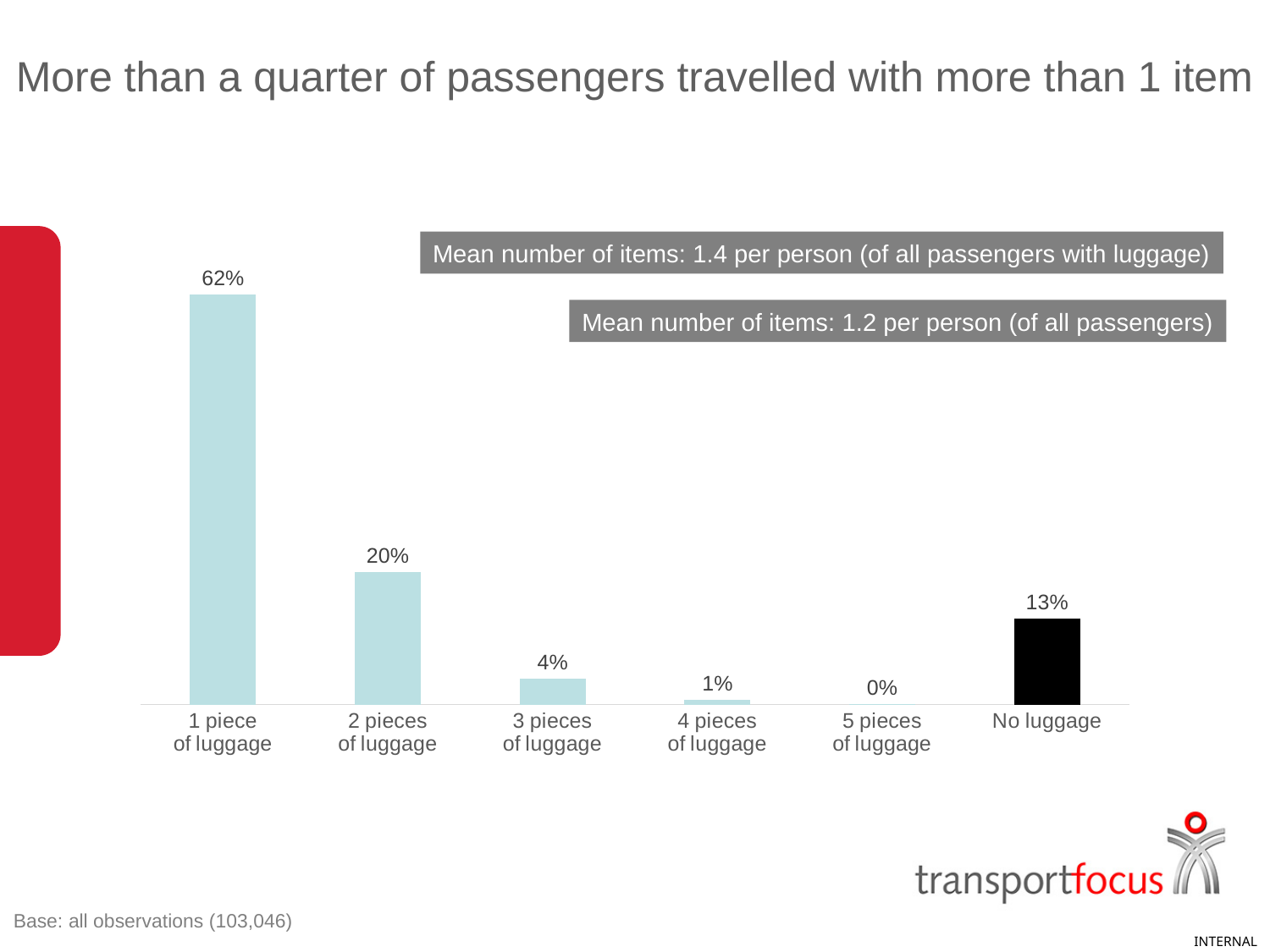
How many categories are shown on the x axis? 6 What percentage of passengers travelled with 1 piece of luggage? 62% What is the mean number of items per person of all passengers with luggage, as stated on the slide? 1.4 What kind of chart is shown on the slide? Bar chart Which category has the highest value? 1 piece of luggage What is the value shown for 'No luggage'? 13% Which category has the lowest value? 5 pieces of luggage Which bar is coloured black rather than light blue? No luggage Which is larger: the value for 2 pieces of luggage or the value for No luggage? 2 pieces of luggage What percentage of passengers travelled with 2 pieces of luggage? 20% What percentage of passengers travelled with 3 pieces of luggage? 4% What is the difference between the values for 1 piece of luggage and 2 pieces of luggage? 42%